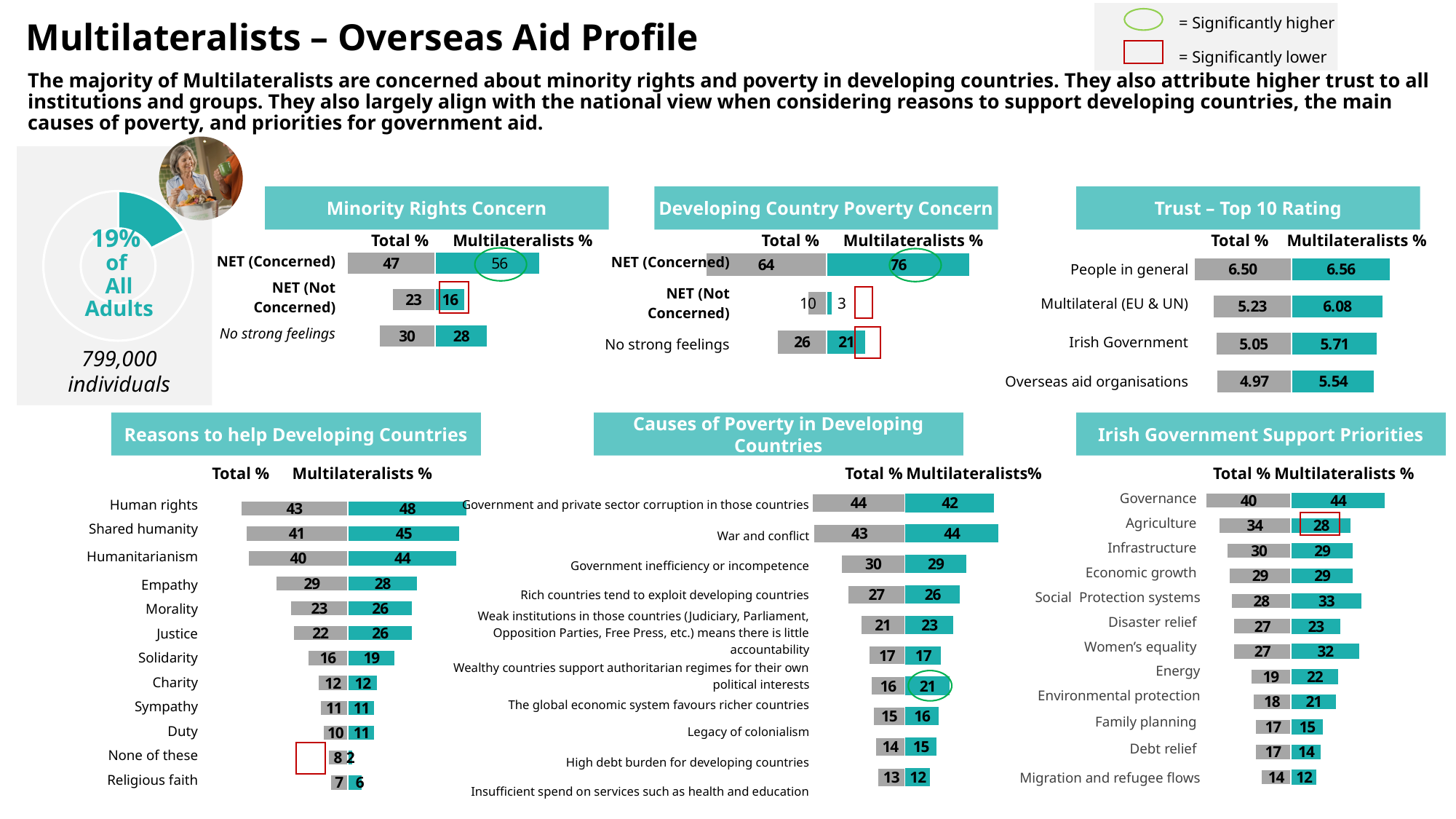
In the Irish Government Support Priorities chart, what is the Multilateralists % for Social Protection systems? 33 In the Developing Country Poverty Concern chart, what is the difference between the Multilateralists % and the Total % for NET (Concerned)? 12 In the Trust – Top 10 Rating chart, which item has the lowest Total rating? Overseas aid organisations In the Irish Government Support Priorities chart, which is larger for Agriculture: the Total % or the Multilateralists %? Total % How many reasons are listed in the Reasons to help Developing Countries chart? 12 In the Reasons to help Developing Countries chart, what is the Multilateralists % for Justice? 26 In the Reasons to help Developing Countries chart, which reason has the highest Multilateralists %? Human rights In the Developing Country Poverty Concern chart, what is the Total % for NET (Concerned)? 64 In the Trust – Top 10 Rating chart, what is the Multilateralists rating for Multilateral (EU & UN)? 6.08 What type of chart is used in the Irish Government Support Priorities section? Bar chart In the Minority Rights Concern chart, what is the Multilateralists % for NET (Concerned)? 56 In the Causes of Poverty in Developing Countries chart, what is the Total % for War and conflict? 43